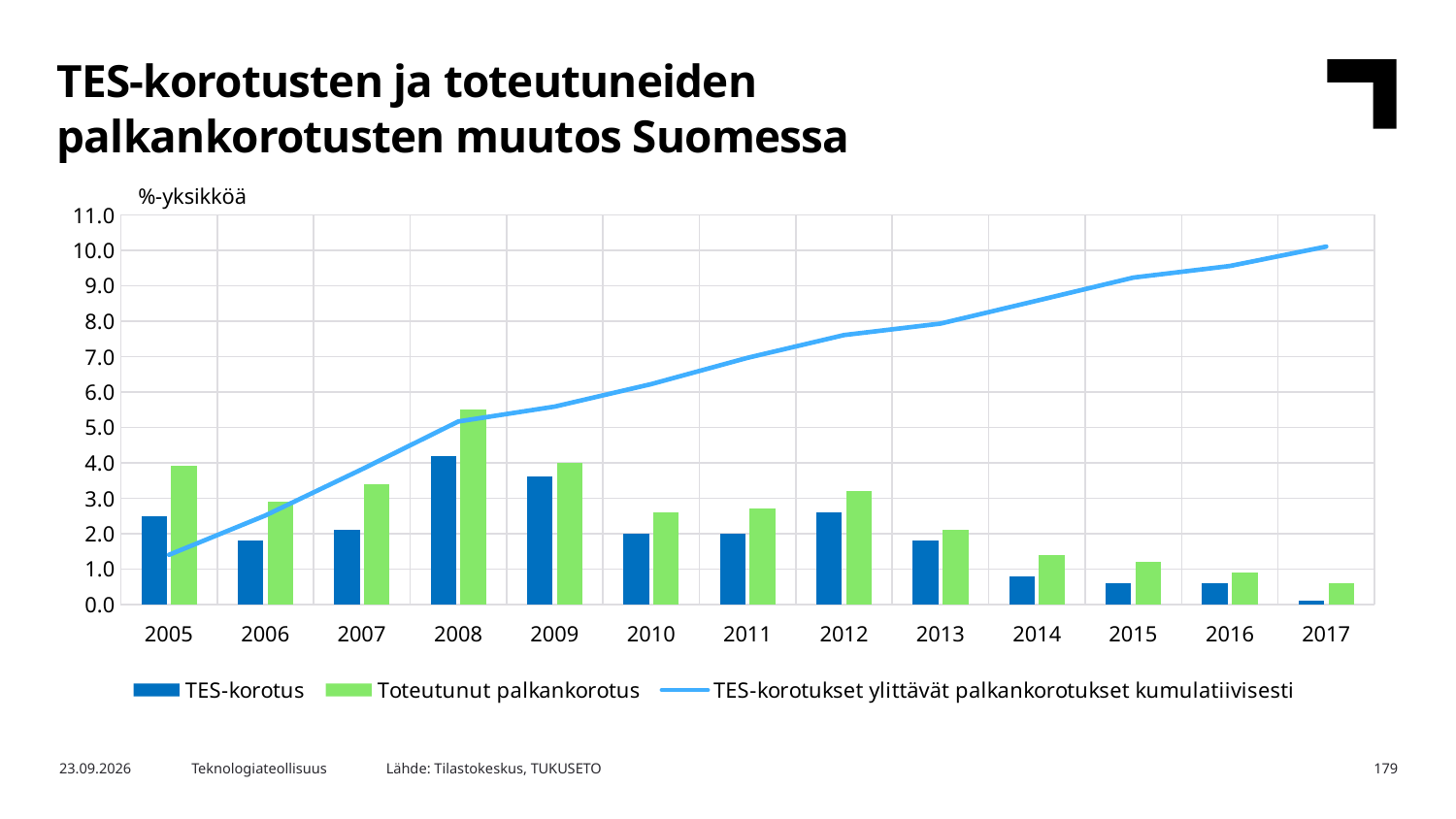
In which year is the Toteutunut palkankorotus bar highest? 2008 Which is larger in 2005, TES-korotus or Toteutunut palkankorotus? Toteutunut palkankorotus What kind of chart is shown on the slide? A bar chart combined with a line How many years are shown on the x axis? 13 In which year is the TES-korotus bar lowest? 2017 Is the value for TES-korotus in 2017 greater or less than 1.0? less Does the TES-korotukset ylittävät palkankorotukset kumulatiivisesti line rise or fall from 2005 to 2017? rise What unit is shown above the y axis? %-yksikköä How many series does the legend list? 3 Is the value for Toteutunut palkankorotus in 2008 greater or less than 5.0? greater Is the value of the TES-korotukset ylittävät palkankorotukset kumulatiivisesti line in 2017 greater or less than 9.0? greater In which year is the TES-korotus bar highest? 2008